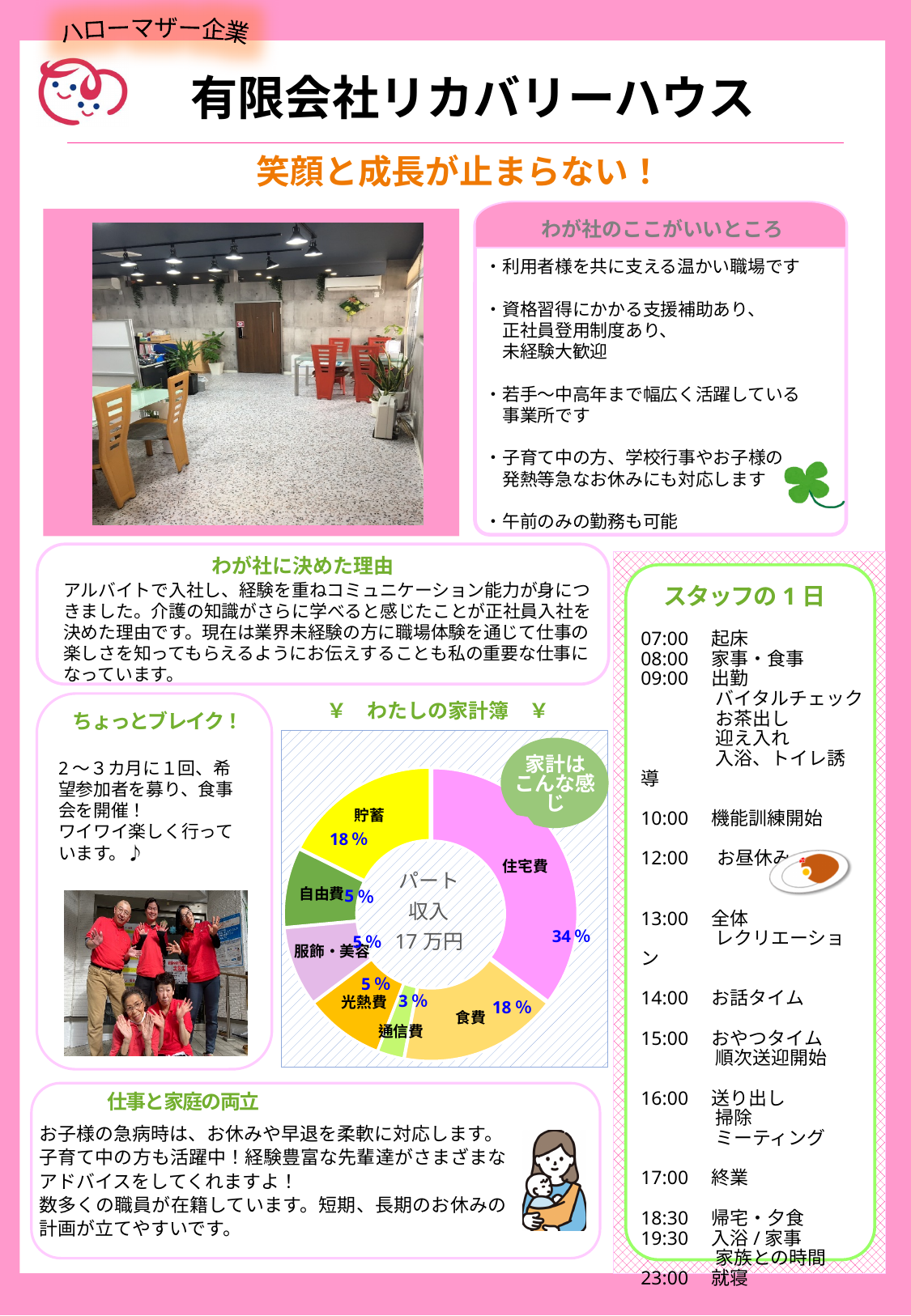
In the わたしの家計簿 chart, what percentage is 住宅費? 34% In the わたしの家計簿 chart, what is the difference between the 住宅費 share and the 食費 share? 16% In the わたしの家計簿 chart, which is larger, 貯蓄 or 自由費? 貯蓄 In the わたしの家計簿 chart, what percentage is 貯蓄? 18% In the わたしの家計簿 chart, what percentage is 通信費? 3% In the わたしの家計簿 chart, what percentage is 光熱費? 5% In the わたしの家計簿 chart, what is the combined share of 住宅費 and 食費? 52% How many categories are shown in the わたしの家計簿 chart? 7 In the わたしの家計簿 chart, which category has the largest share? 住宅費 What kind of chart is the わたしの家計簿 chart? Donut (pie) chart In the わたしの家計簿 chart, which category has the smallest share? 通信費 What income amount is written in the center of the わたしの家計簿 chart? パート収入 17万円